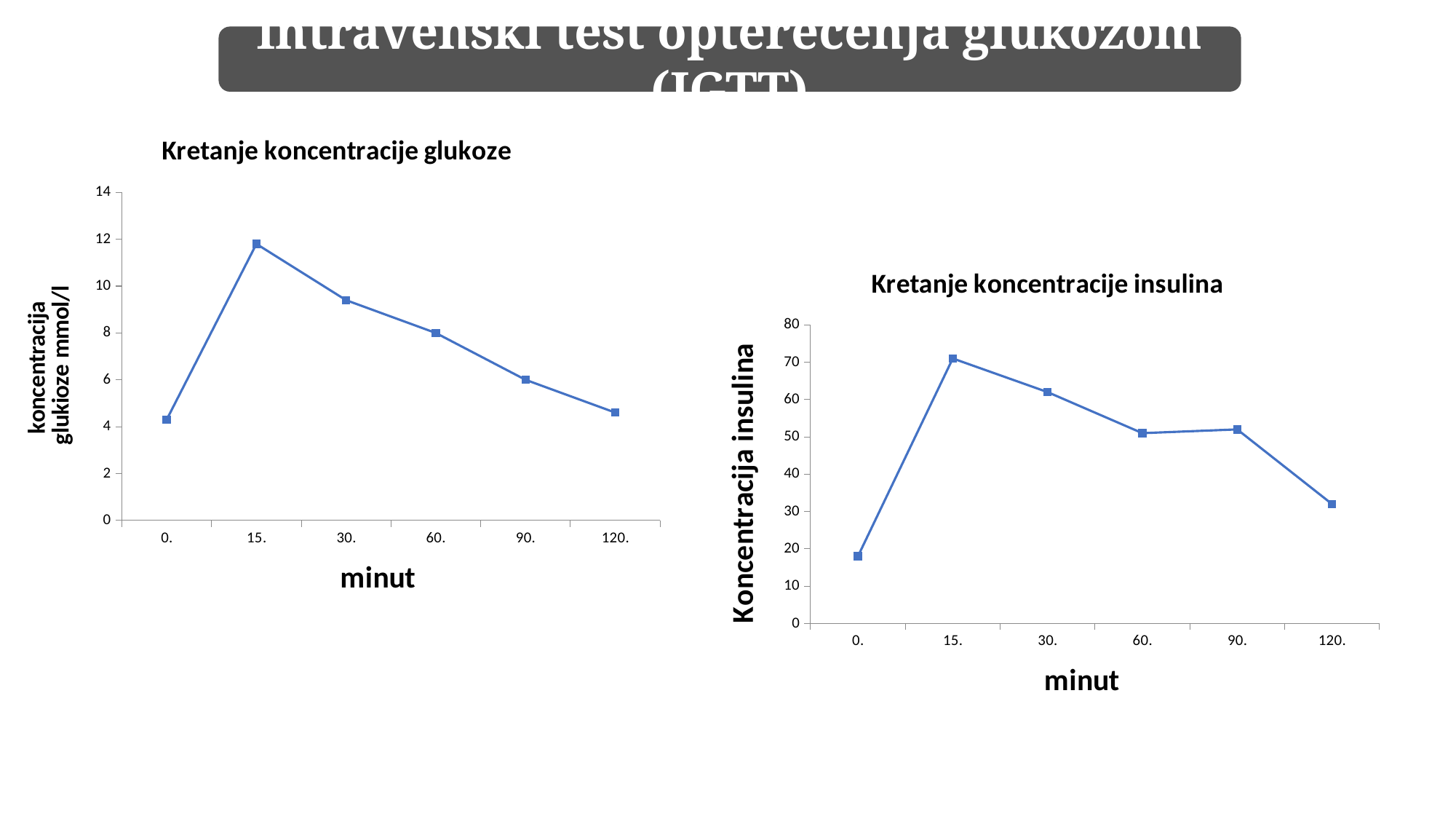
In the 'Kretanje koncentracije glukoze' chart, what is the glucose concentration at 90 minutes? 6 In the 'Kretanje koncentracije insulina' chart, at which minute is the insulin concentration highest? 15. In the 'Kretanje koncentracije insulina' chart, at which minute is the insulin concentration lowest? 0. What type of chart is 'Kretanje koncentracije glukoze'? line chart In the 'Kretanje koncentracije glukoze' chart, do the values rise or fall from 15 minutes to 120 minutes? fall In the 'Kretanje koncentracije insulina' chart, is the value at 15 minutes greater or less than 60? greater In the 'Kretanje koncentracije glukoze' chart, is the value at 0 minutes greater or less than 6? less In the 'Kretanje koncentracije glukoze' chart, at which minute is the glucose concentration highest? 15. In the 'Kretanje koncentracije glukoze' chart, is the value at 15 minutes greater or less than 10? greater In the 'Kretanje koncentracije glukoze' chart, how many time points are plotted? 6 In the 'Kretanje koncentracije glukoze' chart, what is the glucose concentration at 60 minutes? 8 In the 'Kretanje koncentracije insulina' chart, which is larger, the value at 30 minutes or at 120 minutes? 30.